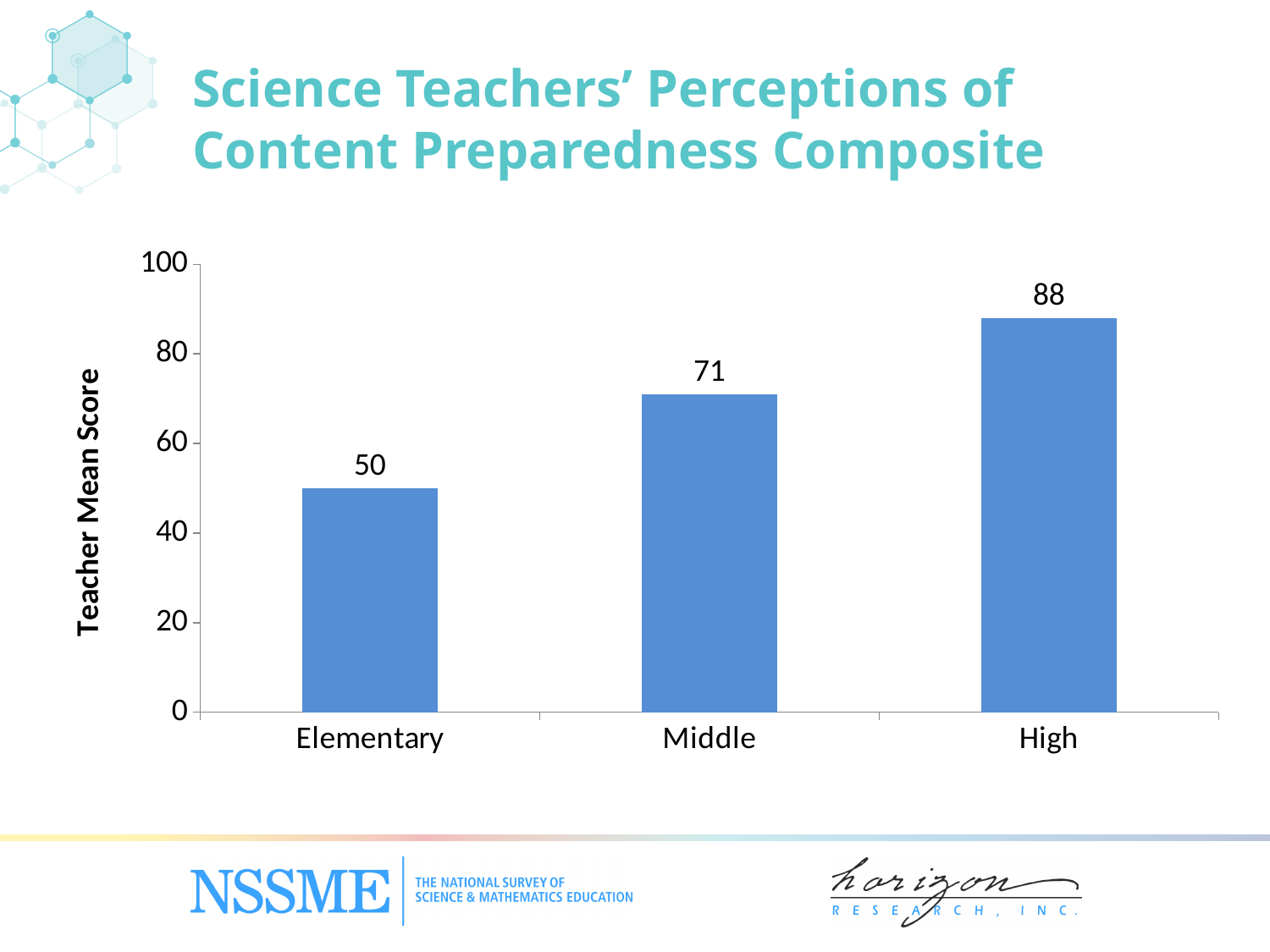
What is the teacher mean score for High? 88 What is the teacher mean score for Elementary? 50 What is the difference between the teacher mean scores for Middle and Elementary? 21 What kind of chart is shown on the slide? Bar chart Is the value for Middle greater or less than 60? greater What is the teacher mean score for Middle? 71 What is the difference between the teacher mean scores for High and Elementary? 38 Which has a larger teacher mean score, Middle or High? High Do the teacher mean scores rise or fall from Elementary to High? Rise Which grade level has the highest teacher mean score? High Which grade level has the lowest teacher mean score? Elementary How many grade-level categories are shown on the chart? 3